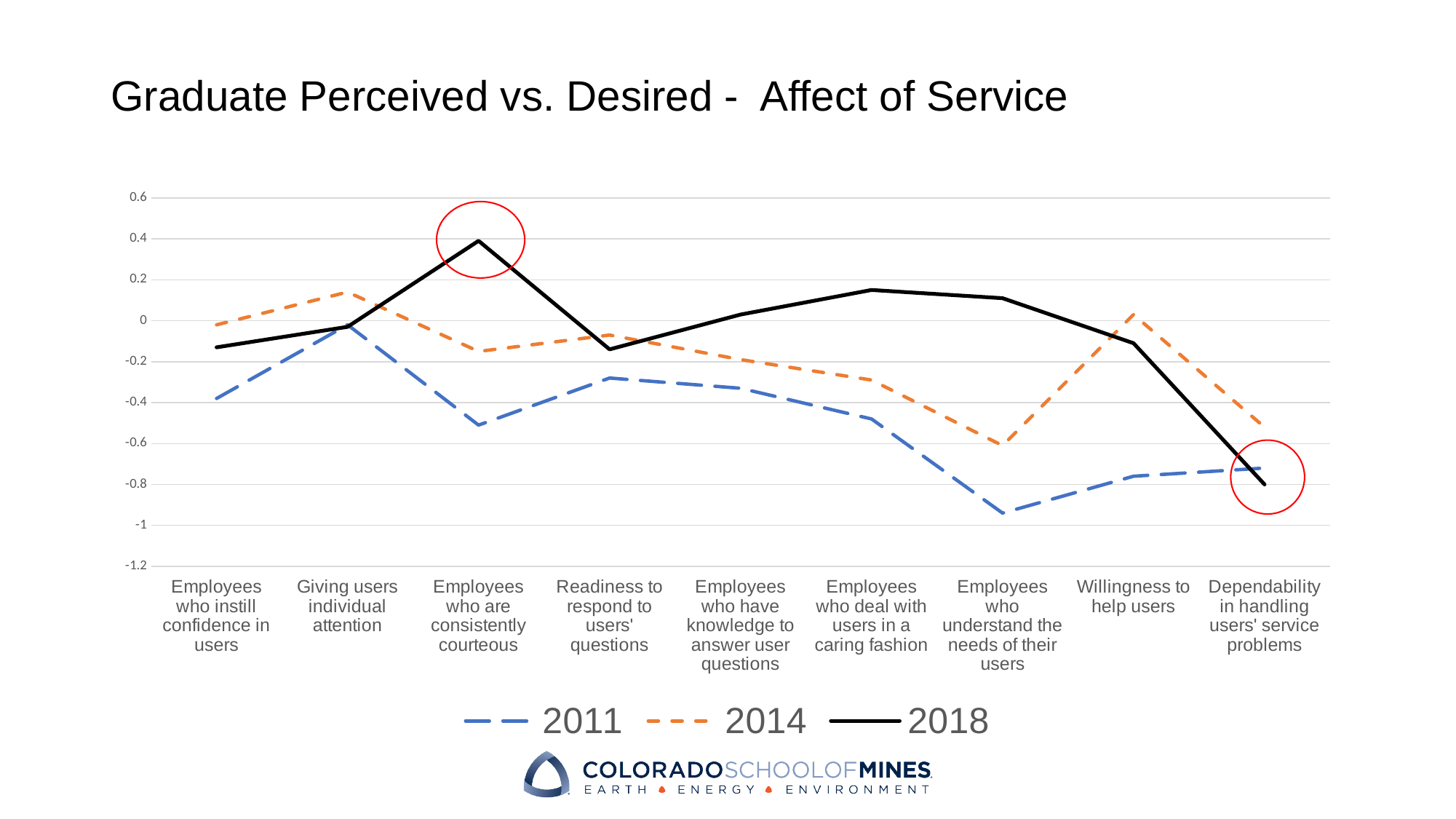
For the 2011 series, which category has the lowest value? Employees who understand the needs of their users What is the title of the chart? Graduate Perceived vs. Desired - Affect of Service For "Willingness to help users", which series has the higher value, 2014 or 2011? 2014 How many series does the legend list? 3 Is the 2011 value for "Employees who understand the needs of their users" greater or less than -0.8? less How many categories are plotted along the x axis? 9 For the 2018 series, which category has the highest value? Employees who are consistently courteous For the 2018 series, which category has the lowest value? Dependability in handling users' service problems Is the 2018 value for "Employees who are consistently courteous" greater or less than 0.2? greater What kind of chart is shown on the slide? line chart For "Employees who are consistently courteous", which series has the higher value, 2018 or 2011? 2018 For the 2014 series, which category has the lowest value? Employees who understand the needs of their users